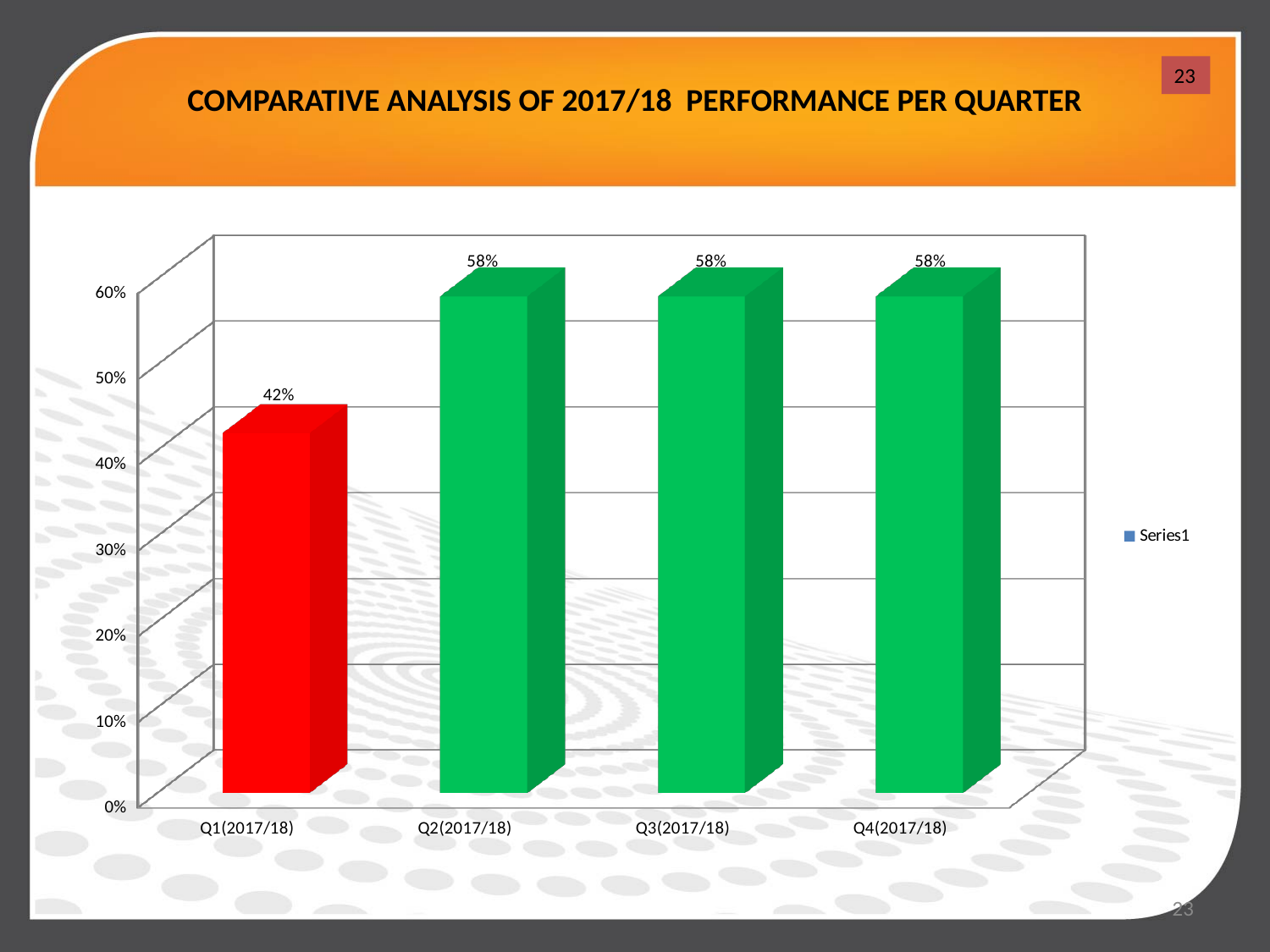
What is the title of the chart? COMPARATIVE ANALYSIS OF 2017/18 PERFORMANCE PER QUARTER How many quarters are shown on the x axis? 4 Which is larger, the value for Q1(2017/18) or the value for Q3(2017/18)? Q3(2017/18) How many series does the legend list? 1 What is the value for Q4(2017/18)? 58% Which quarter has the lowest value? Q1(2017/18) What is the value for Q2(2017/18)? 58% Is the value for Q1(2017/18) greater or less than 50%? less What colour is the bar for Q1(2017/18)? red What is the difference between the values for Q2(2017/18) and Q1(2017/18)? 16% What is the value for Q1(2017/18)? 42% What kind of chart is shown on the slide? bar chart